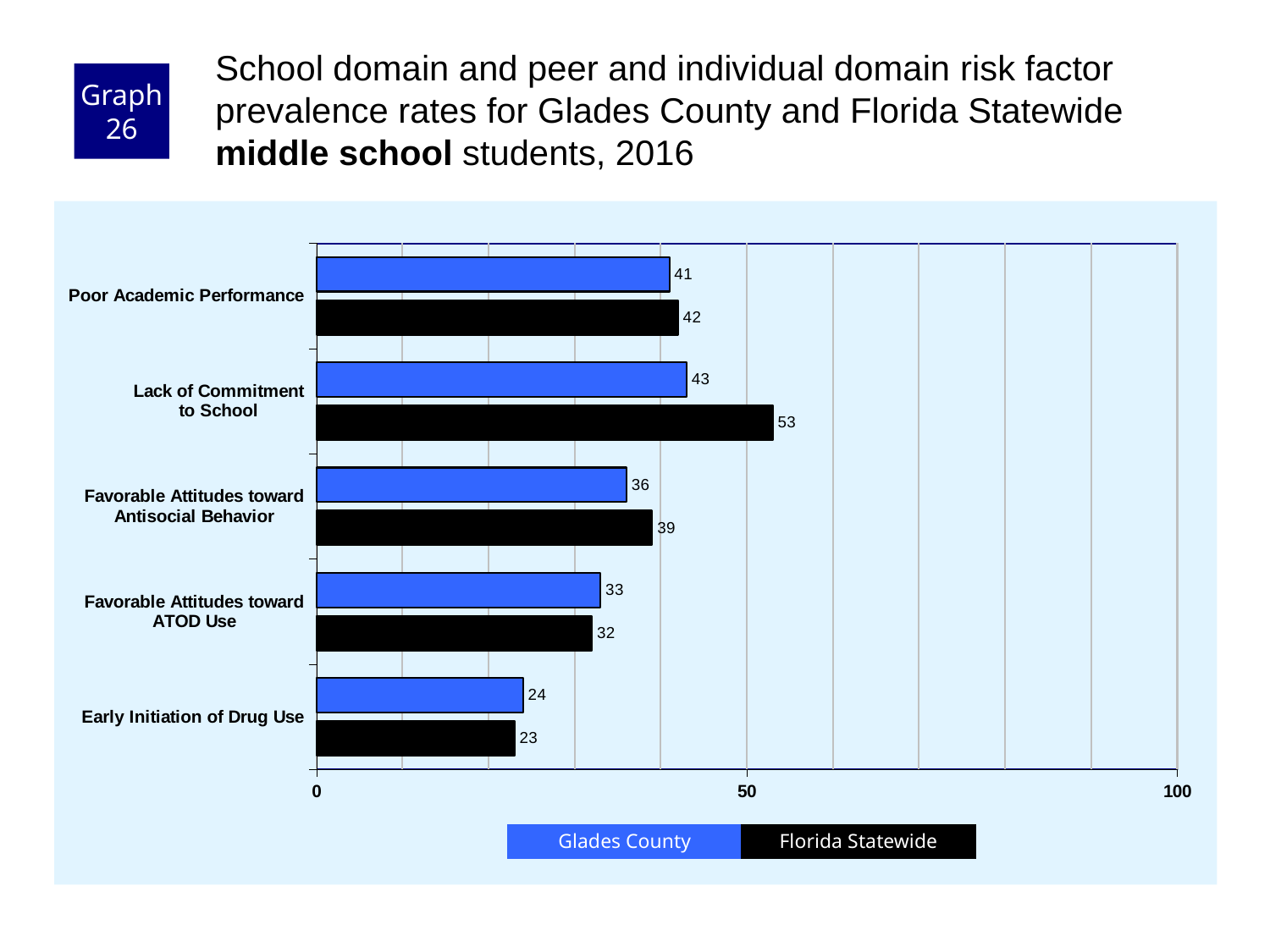
For Favorable Attitudes toward ATOD Use, which is larger: the Glades County value or the Florida Statewide value? Glades County What is the Glades County value for Lack of Commitment to School? 43 Which colour represents Florida Statewide in the chart? black How many risk factor categories are shown on the chart? 5 What kind of chart is shown on the slide? bar chart What is the Florida Statewide value for Favorable Attitudes toward Antisocial Behavior? 39 Is the Florida Statewide value for Lack of Commitment to School greater or less than 50? greater What is the Florida Statewide value for Early Initiation of Drug Use? 23 Which risk factor has the highest Florida Statewide value? Lack of Commitment to School What is the difference between the Florida Statewide and Glades County values for Lack of Commitment to School? 10 How many series does the legend list? 2 Which risk factor has the lowest Glades County value? Early Initiation of Drug Use